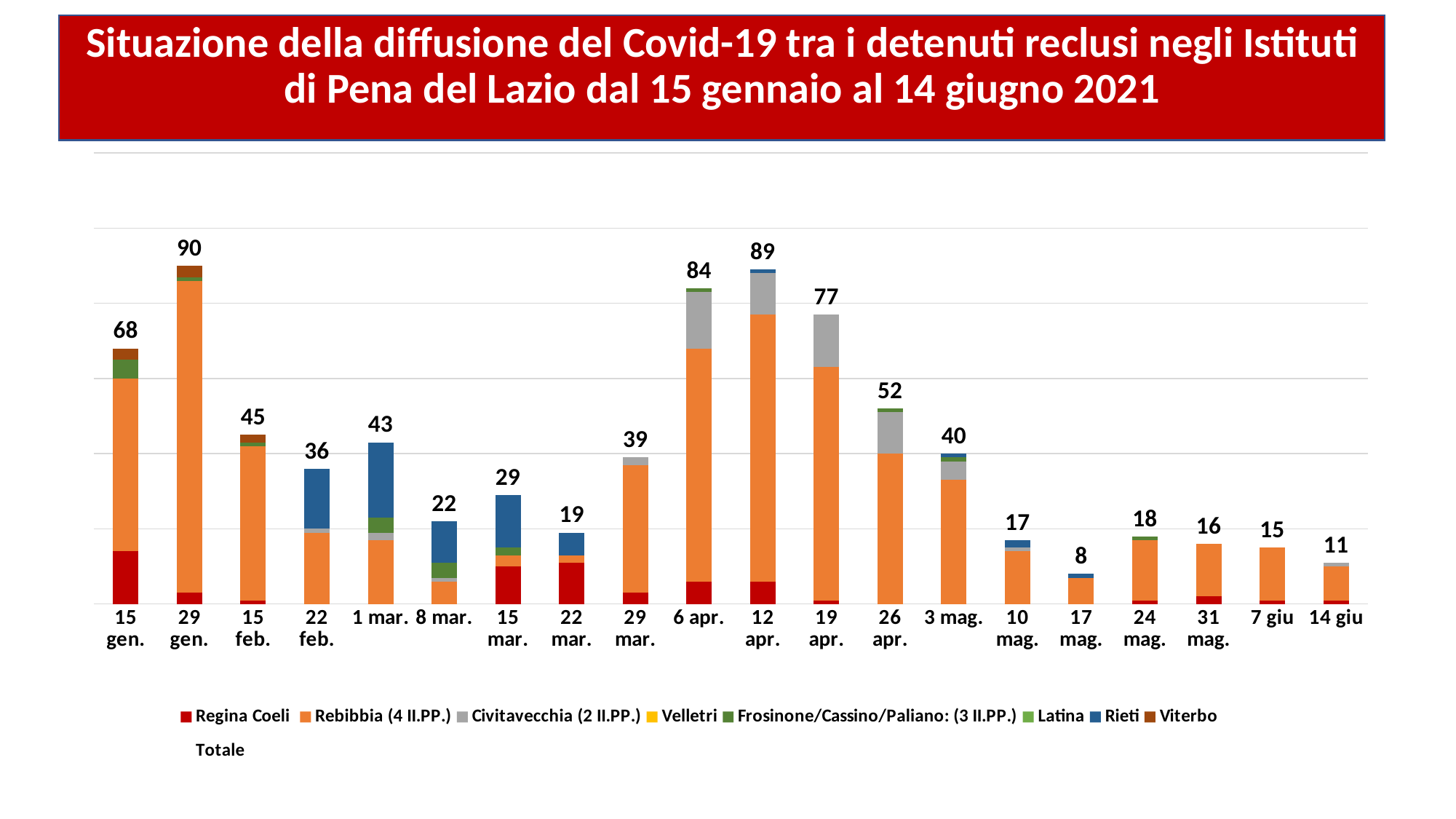
Which date has the highest total? 29 gen. What is the difference between the totals for 12 apr. and 6 apr.? 5 What is the total value shown for 14 giu? 11 How many entries does the legend list? 9 Which total is larger, 19 apr. or 26 apr.? 19 apr. Which date has the lowest total? 17 mag. Do the totals rise or fall from 12 apr. to 17 mag.? Fall What is the difference between the totals for 29 gen. and 17 mag.? 82 What is the total value shown for 12 apr.? 89 How many dates are shown on the x axis? 20 What kind of chart is shown on the slide? Stacked bar chart What is the total value shown for 29 gen.? 90